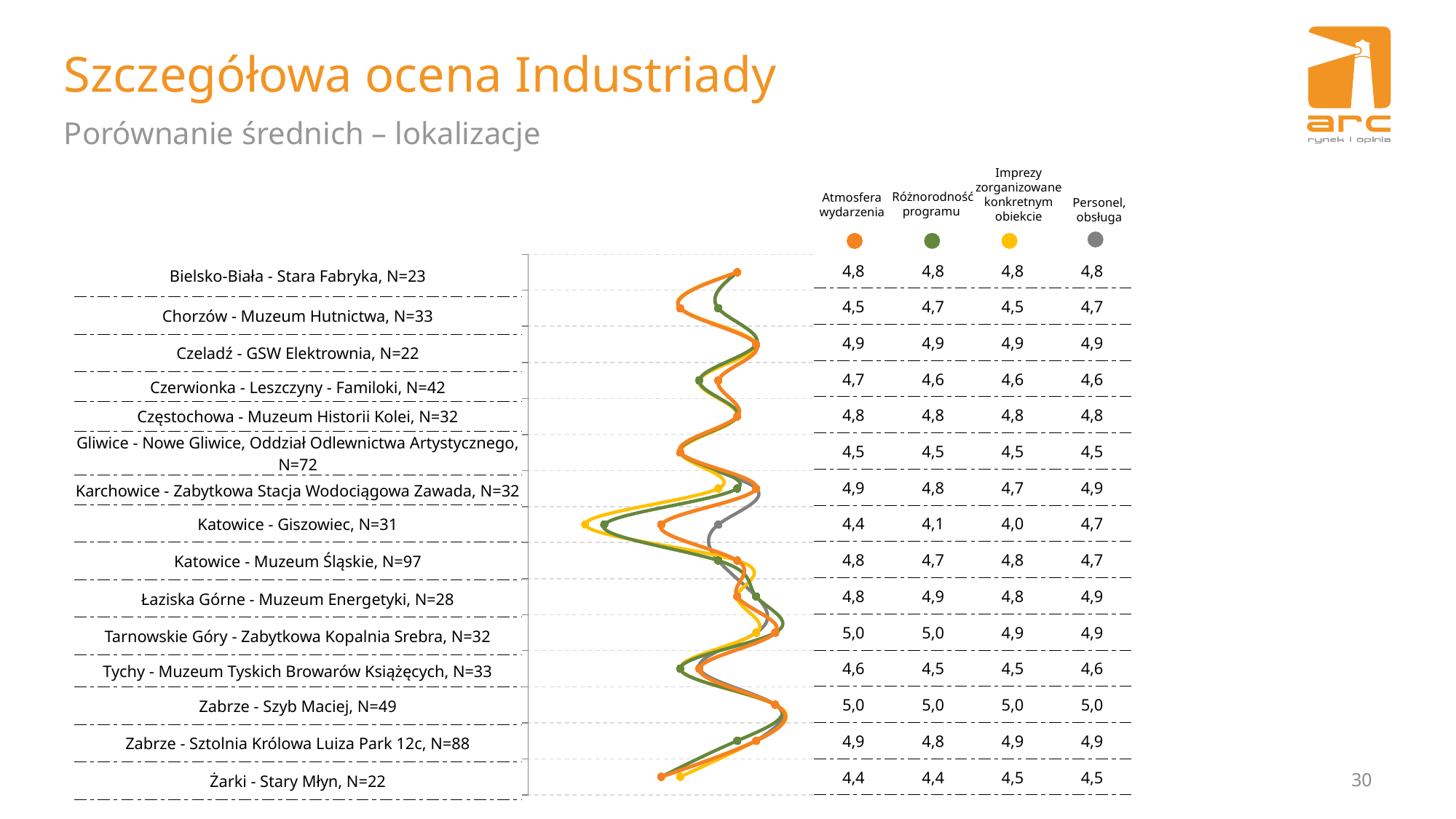
Which location has the lowest value for Imprezy zorganizowane konkretnym obiekcie? Katowice - Giszowiec, N=31 How many locations are listed in the chart? 15 What is the value of Atmosfera wydarzenia for Katowice - Giszowiec, N=31? 4,4 What kind of chart is shown on the slide? Line chart Which location has the lowest value for Różnorodność programu? Katowice - Giszowiec, N=31 What is the value of Różnorodność programu for Zabrze - Sztolnia Królowa Luiza Park 12c, N=88? 4,8 What colour represents the Personel, obsługa series? Gray For Chorzów - Muzeum Hutnictwa, N=33, which is higher: Atmosfera wydarzenia or Różnorodność programu? Różnorodność programu What is the value of Imprezy zorganizowane konkretnym obiekcie for Karchowice - Zabytkowa Stacja Wodociągowa Zawada, N=32? 4,7 What is the value of Personel, obsługa for Chorzów - Muzeum Hutnictwa, N=33? 4,7 How many series does the legend list? 4 For Katowice - Giszowiec, N=31, what is the difference between Personel, obsługa and Różnorodność programu? 0,6